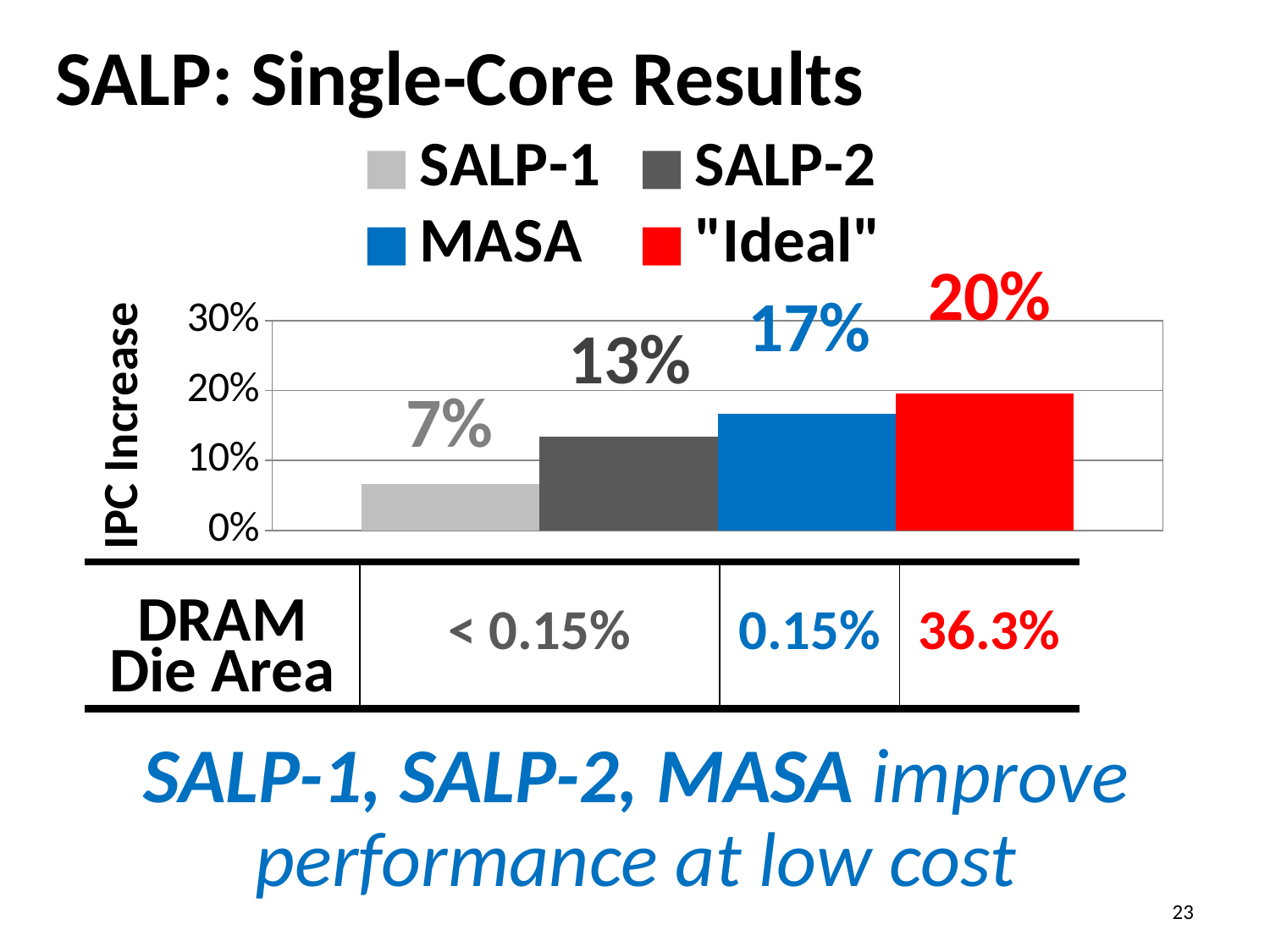
What is the IPC increase for SALP-2? 13% What is the IPC increase for SALP-1? 7% What is the IPC increase for MASA? 17% What is the difference in IPC increase between MASA and SALP-1? 10% Which has a larger IPC increase, SALP-2 or MASA? MASA Is the IPC increase for SALP-2 greater or less than 10%? greater Which series has the highest IPC increase? "Ideal" Which series has the lowest IPC increase? SALP-1 What is the IPC increase for "Ideal"? 20% What is the label of the vertical axis? IPC Increase What kind of chart is shown on the slide? bar chart How many series does the legend list? 4